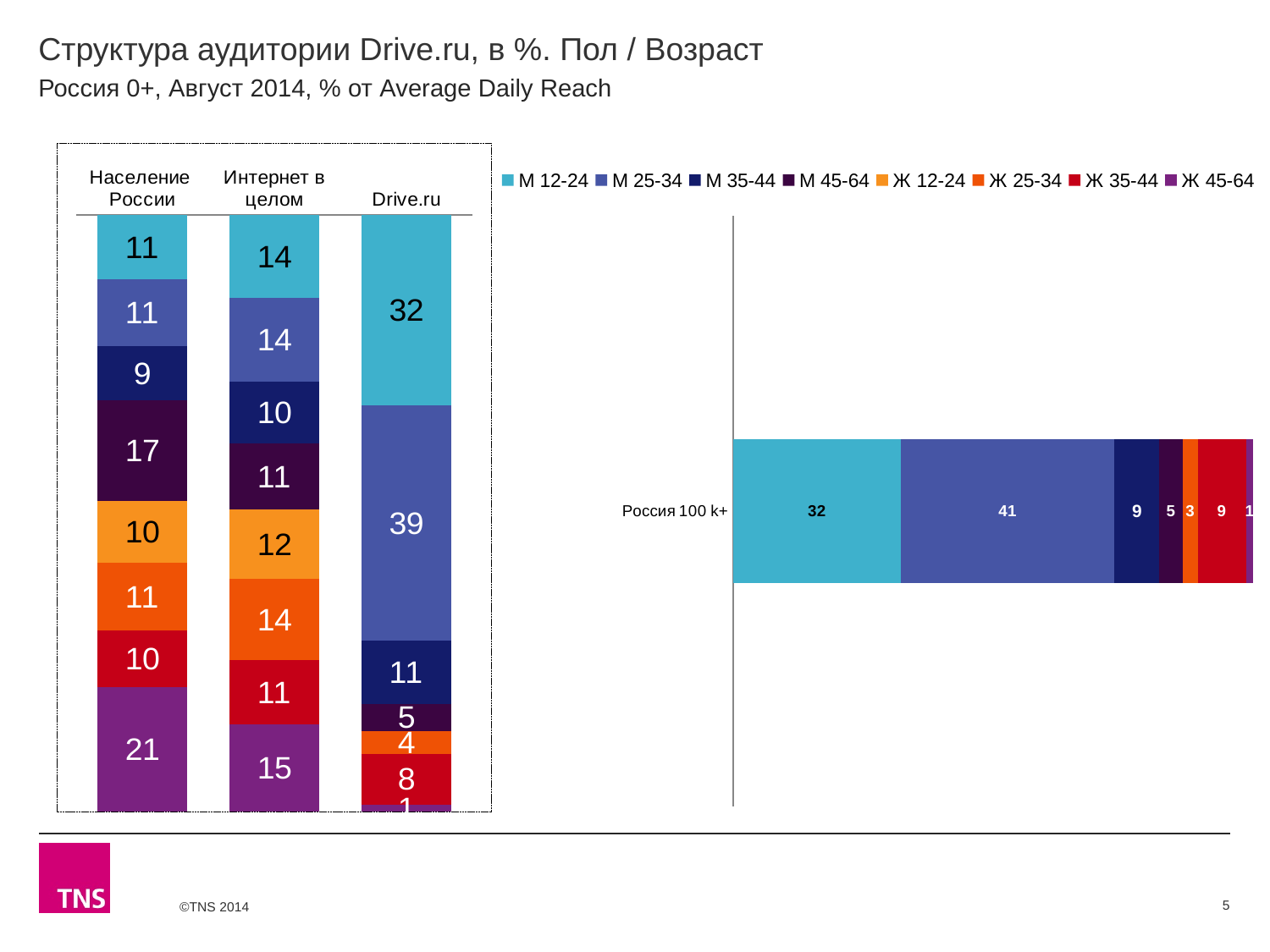
How many columns (categories) does the left chart show? 3 In the left chart, what is the value for Ж 45-64 in the Население России column? 21 In the left chart, what is the value for М 25-34 in the Drive.ru column? 39 In the left chart, which is larger: М 45-64 for Население России or М 45-64 for Drive.ru? Население России In the left chart, what is the value for М 35-44 in the Интернет в целом column? 10 In the right chart, what is the difference between М 25-34 and М 12-24 for Россия 100 k+? 9 In the left chart, which segment is the largest in the Drive.ru column? М 25-34 In the left chart, which segment is the smallest in the Население России column? М 35-44 In the left chart, what is the difference between М 12-24 for Drive.ru and М 12-24 for Интернет в целом? 18 How many series does the legend list? 8 In the right chart, what is the value for М 25-34 for Россия 100 k+? 41 What kind of chart is the right chart (Россия 100 k+)? Stacked bar chart